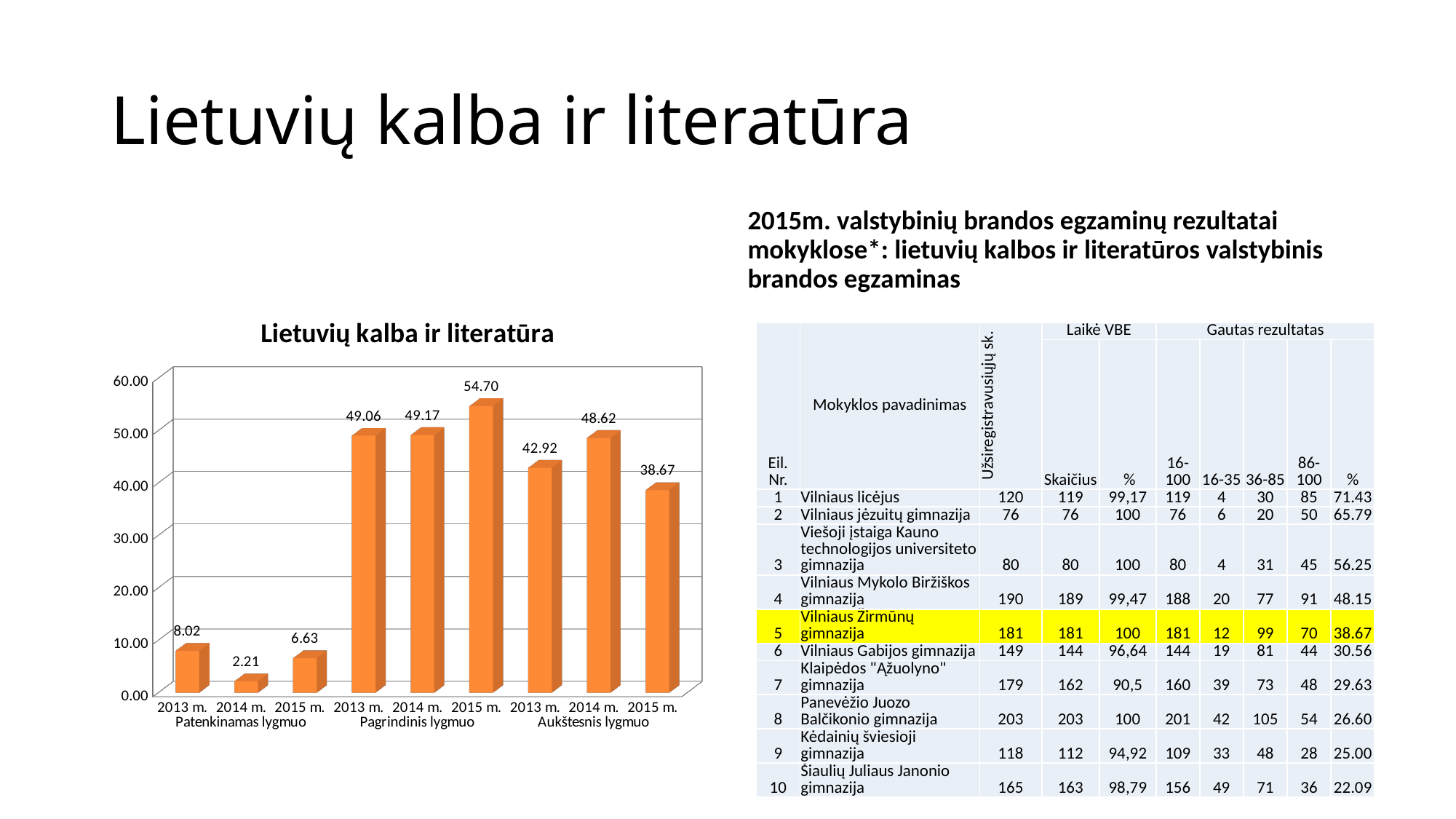
What is the value for 2015 m. in the Aukštesnis lygmuo group? 38.67 What is the value for 2014 m. in the Patenkinamas lygmuo group? 2.21 Do the values in the Aukštesnis lygmuo group rise or fall from 2014 m. to 2015 m.? Fall Which bar has the lowest value in the chart? 2014 m. Patenkinamas lygmuo How many bars are plotted in the chart? 9 What type of chart is shown on the slide? Bar chart What is the difference between the 2015 m. and 2013 m. values in the Pagrindinis lygmuo group? 5.64 What is the title of the chart? Lietuvių kalba ir literatūra Which bar has the highest value in the chart? 2015 m. Pagrindinis lygmuo Which is larger: the 2014 m. value for Aukštesnis lygmuo or the 2014 m. value for Pagrindinis lygmuo? 2014 m. Pagrindinis lygmuo What is the value for 2013 m. in the Aukštesnis lygmuo group? 42.92 What is the value for 2015 m. in the Pagrindinis lygmuo group? 54.70